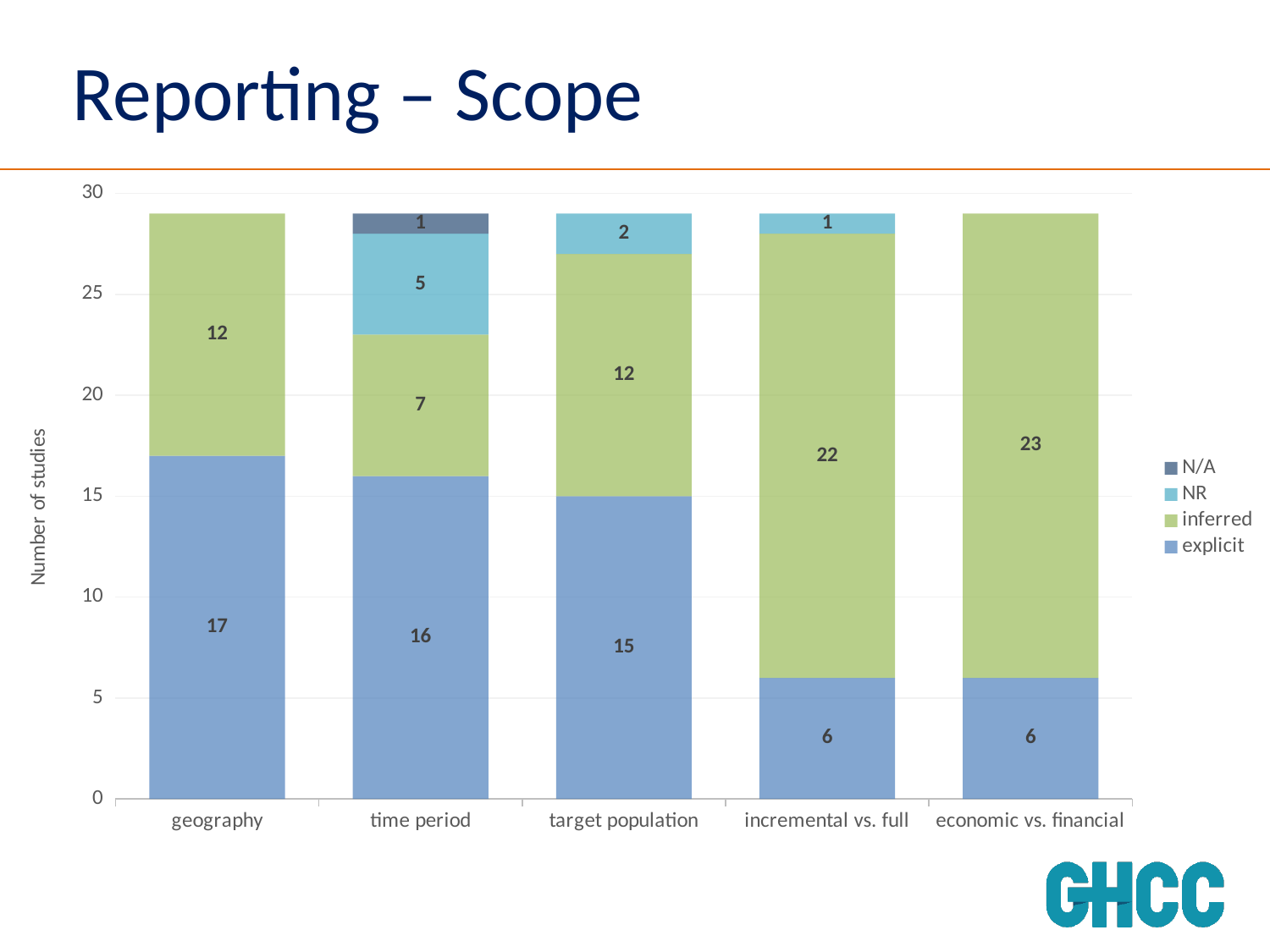
Which category has the highest explicit value? geography What is the total of the stacked bar for time period? 29 What is the explicit value for geography? 17 What is the NR value for time period? 5 Which is larger, the explicit value for target population or the explicit value for incremental vs. full? target population How many categories are shown on the x axis? 5 What is the inferred value for economic vs. financial? 23 What is the label of the y axis? Number of studies How many series does the legend list? 4 Which category has the lowest inferred value? time period What kind of chart is shown on the slide? Stacked bar chart What is the difference between the inferred values for incremental vs. full and time period? 15